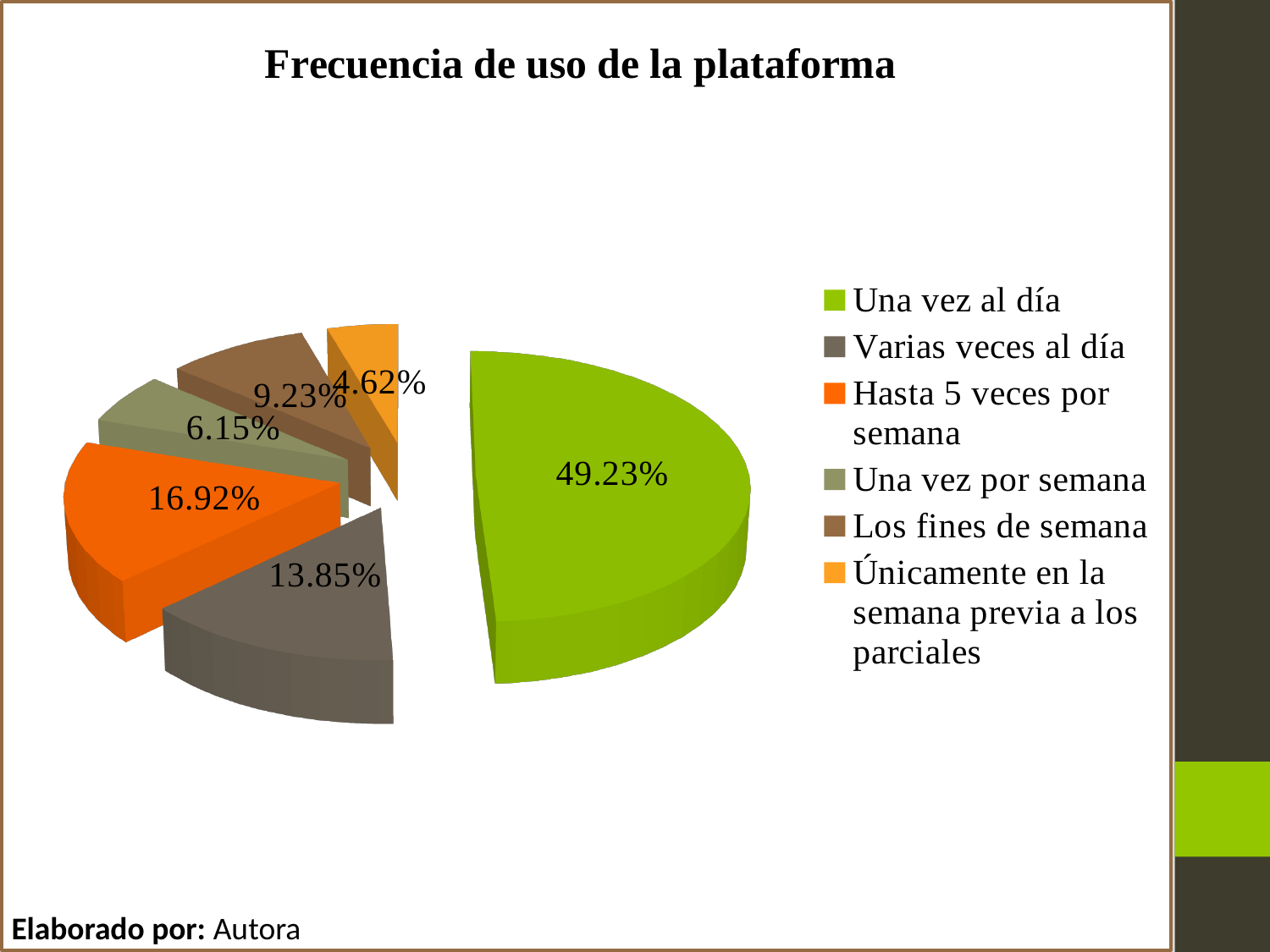
Which category has the smallest share of the pie? Únicamente en la semana previa a los parciales What percentage is shown for "Hasta 5 veces por semana"? 16.92% How many categories does the legend list? 6 What percentage is shown for "Los fines de semana"? 9.23% Which category has the largest share of the pie? Una vez al día What type of chart is shown on the slide? Pie chart What percentage is shown for "Varias veces al día"? 13.85% What percentage is shown for "Únicamente en la semana previa a los parciales"? 4.62% Which is larger, the share for "Hasta 5 veces por semana" or for "Varias veces al día"? Hasta 5 veces por semana What is the title of the chart? Frecuencia de uso de la plataforma What percentage of the pie corresponds to "Una vez al día"? 49.23% What is the difference between the shares for "Una vez al día" and "Hasta 5 veces por semana"? 32.31%